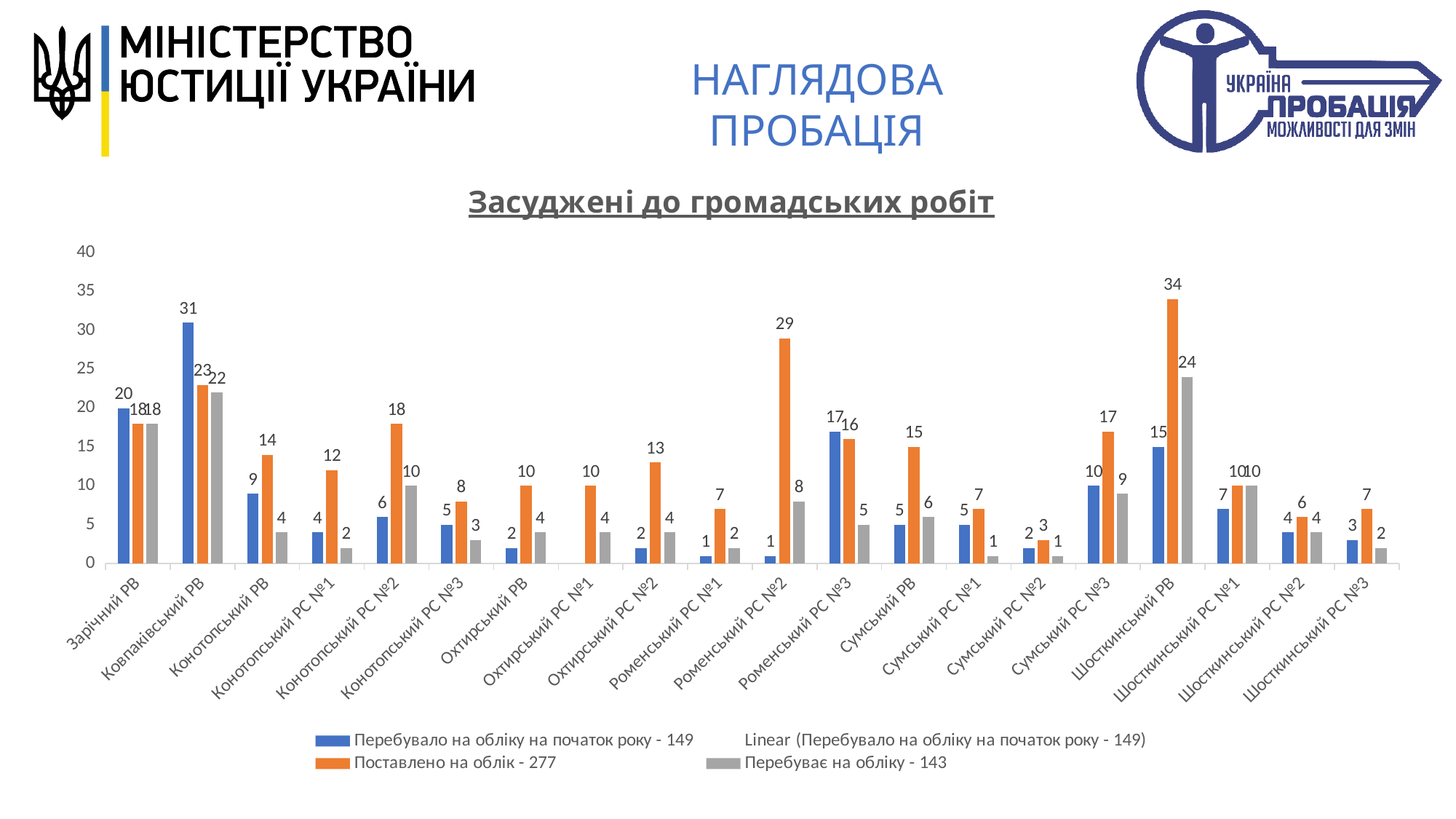
How many categories are shown on the x axis of the chart? 20 What is the value of 'Поставлено на облік - 277' for Шосткинський РВ? 34 What is the difference between 'Поставлено на облік - 277' and 'Перебуває на обліку - 143' for Роменський РС №2? 21 What type of chart is shown on the slide? bar chart What is the value of 'Перебуває на обліку - 143' for Роменський РС №2? 8 What is the value of 'Перебувало на обліку на початок року - 149' for Ковпаківський РВ? 31 What is the value of 'Перебувало на обліку на початок року - 149' for Роменський РС №3? 17 Which category has the highest value for 'Перебувало на обліку на початок року - 149'? Ковпаківський РВ Is the value of 'Поставлено на облік - 277' for Шосткинський РВ greater or less than 30? greater Which is larger for Конотопський РС №2: 'Поставлено на облік - 277' or 'Перебуває на обліку - 143'? Поставлено на облік - 277 What is the title of the chart? Засуджені до громадських робіт Which category has the highest value for 'Поставлено на облік - 277'? Шосткинський РВ